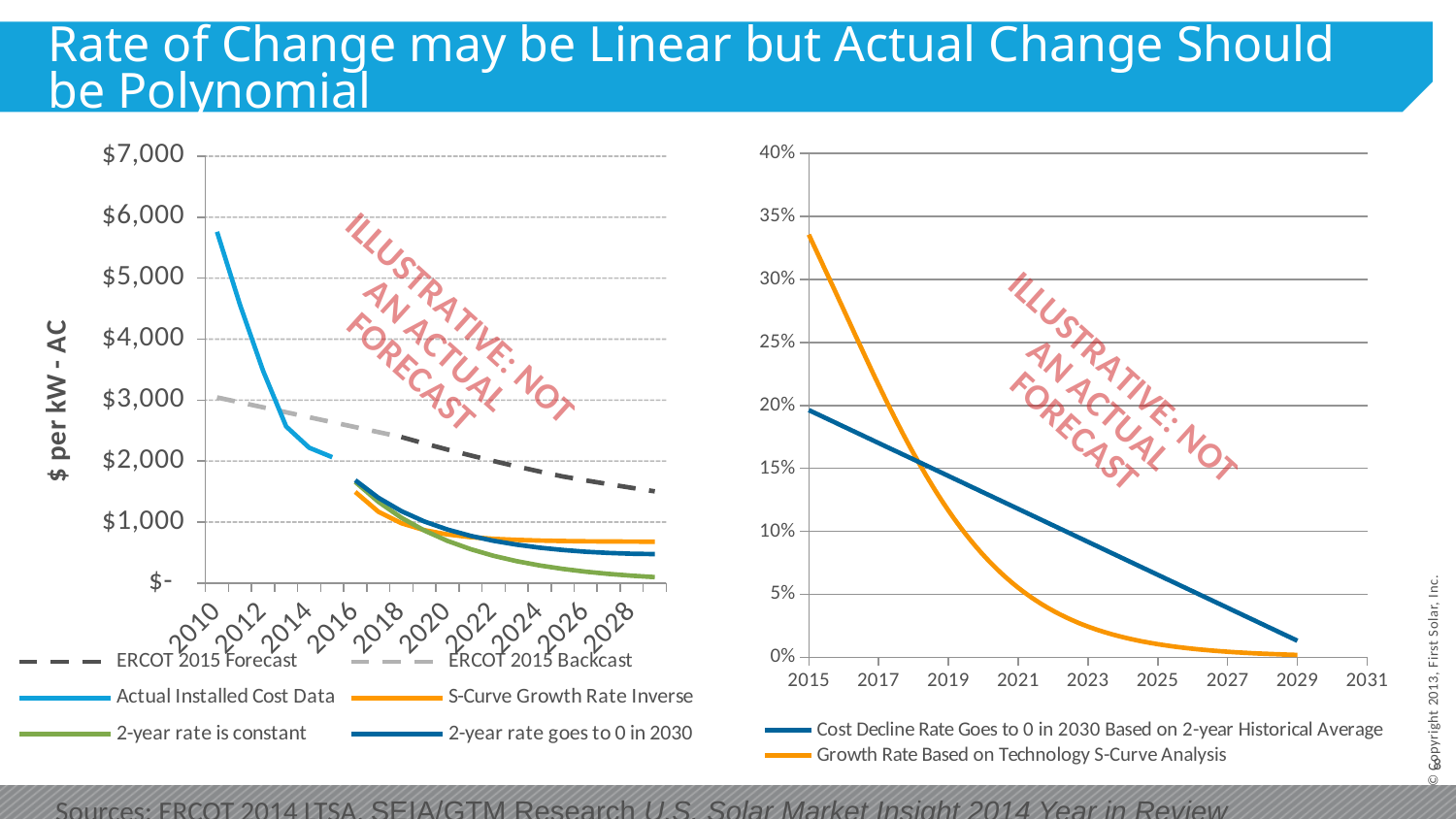
In the right chart, is the value of Growth Rate Based on Technology S-Curve Analysis in 2015 greater or less than 30%? greater How many series does the legend of the left chart list? 6 In the right chart, which series has the higher value in 2025? Cost Decline Rate Goes to 0 in 2030 Based on 2-year Historical Average What is the y-axis title of the left chart? $ per kW - AC In the right chart, is the value of Growth Rate Based on Technology S-Curve Analysis in 2023 greater or less than 5%? less What kind of chart is the left chart on the slide? Line chart In the right chart, do the values of Growth Rate Based on Technology S-Curve Analysis rise or fall from 2015 to 2029? fall In the right chart, which series has the higher value in 2015? Growth Rate Based on Technology S-Curve Analysis In the left chart, is the value of Actual Installed Cost Data in 2010 greater or less than $5,000? greater How many series does the legend of the right chart list? 2 What kind of chart is the right chart on the slide? Line chart